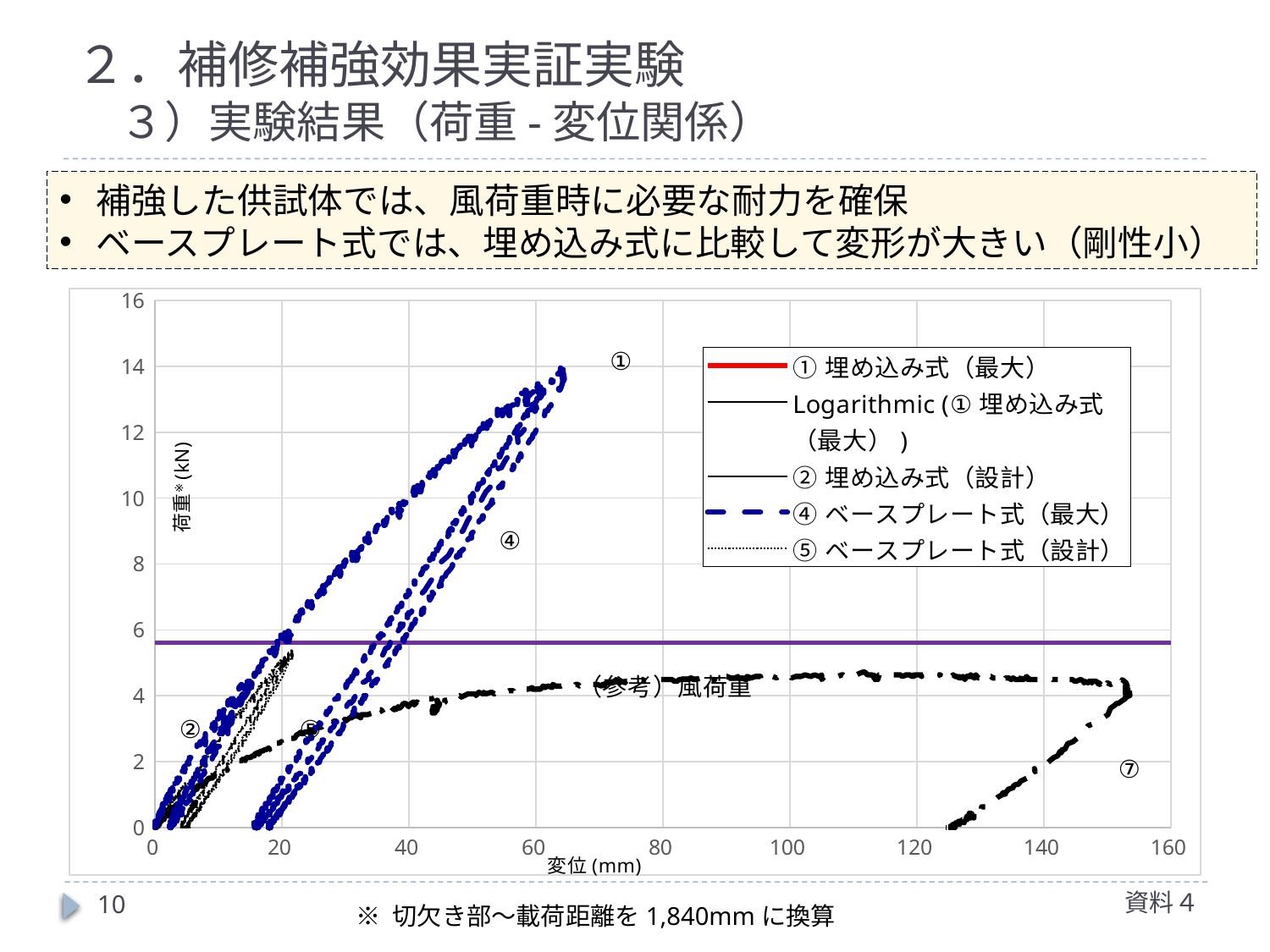
What is the label of the x axis? 変位 (mm) Is the maximum displacement reached by curve ① greater or less than 80 mm? less Is the horizontal reference line labelled （参考）風荷重 above or below 6 kN? below Which reaches a higher peak load, curve ① or curve ⑦? curve ① Is the peak load reached by curve ④ greater or less than 12 kN? greater How many series does the legend list? 5 What kind of chart is shown on the slide? line chart What is the label of the y axis? 荷重※ (kN) What is the highest value shown on the x axis? 160